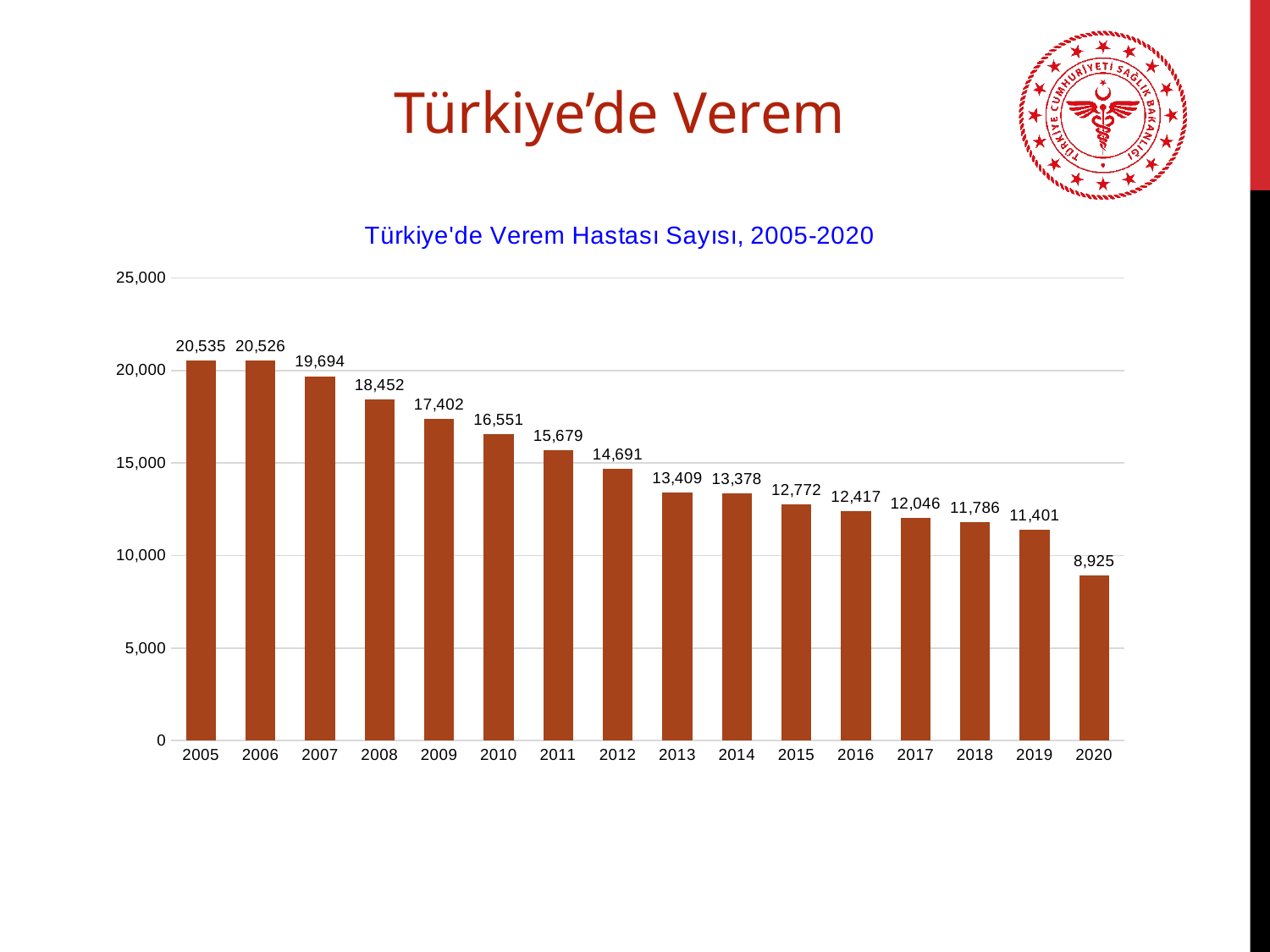
Do the values rise or fall from 2005 to 2020? fall What is the difference between the values for 2005 and 2020? 11,610 Which year has the highest number of patients? 2005 What kind of chart is shown on the slide? bar chart What is the value shown for 2012? 14,691 Is the value for 2017 greater or less than 15,000? less What is the value shown for 2020? 8,925 What is the difference between the values for 2008 and 2009? 1,050 Which is larger, the value for 2010 or the value for 2015? 2010 How many years are shown on the x axis? 16 Which year has the lowest number of patients? 2020 What is the number of tuberculosis patients in Türkiye in 2005? 20,535